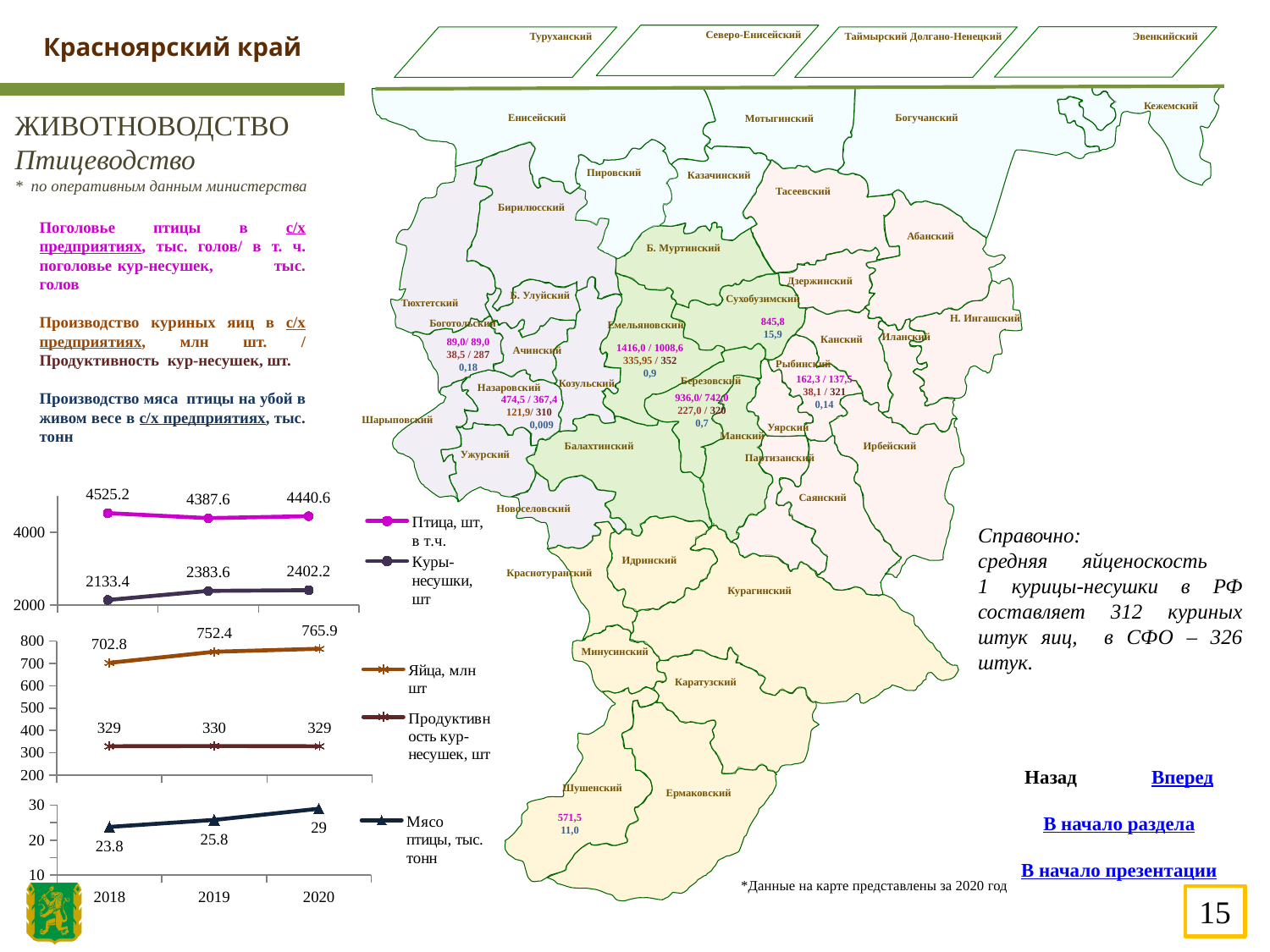
In the bottom line chart on the left, what is the value of 'Мясо птицы, тыс. тонн' for 2020? 29 In the top line chart on the left, what is the value of the 'Птица, шт, в т.ч.' series for 2018? 4525.2 In the middle line chart on the left, does the 'Яйца, млн шт' series rise or fall from 2018 to 2020? rise In the middle line chart on the left, what is the value of 'Продуктивность кур-несушек, шт' for 2019? 330 In the top line chart on the left, what is the difference between the 'Птица, шт, в т.ч.' value and the 'Куры-несушки, шт' value in 2019? 2004 What type of chart is the bottom chart on the left? line chart In the middle line chart on the left, what is the value of 'Яйца, млн шт' for 2019? 752.4 In the top line chart on the left, which year has the lowest value for 'Птица, шт, в т.ч.'? 2019 In the top line chart on the left, what is the value of the 'Куры-несушки, шт' series for 2020? 2402.2 How many series does the legend of the middle line chart on the left list? 2 In the middle line chart on the left, which year has the highest value for 'Яйца, млн шт'? 2020 In the bottom line chart on the left, what is the difference between the 2020 and 2018 values of 'Мясо птицы, тыс. тонн'? 5.2